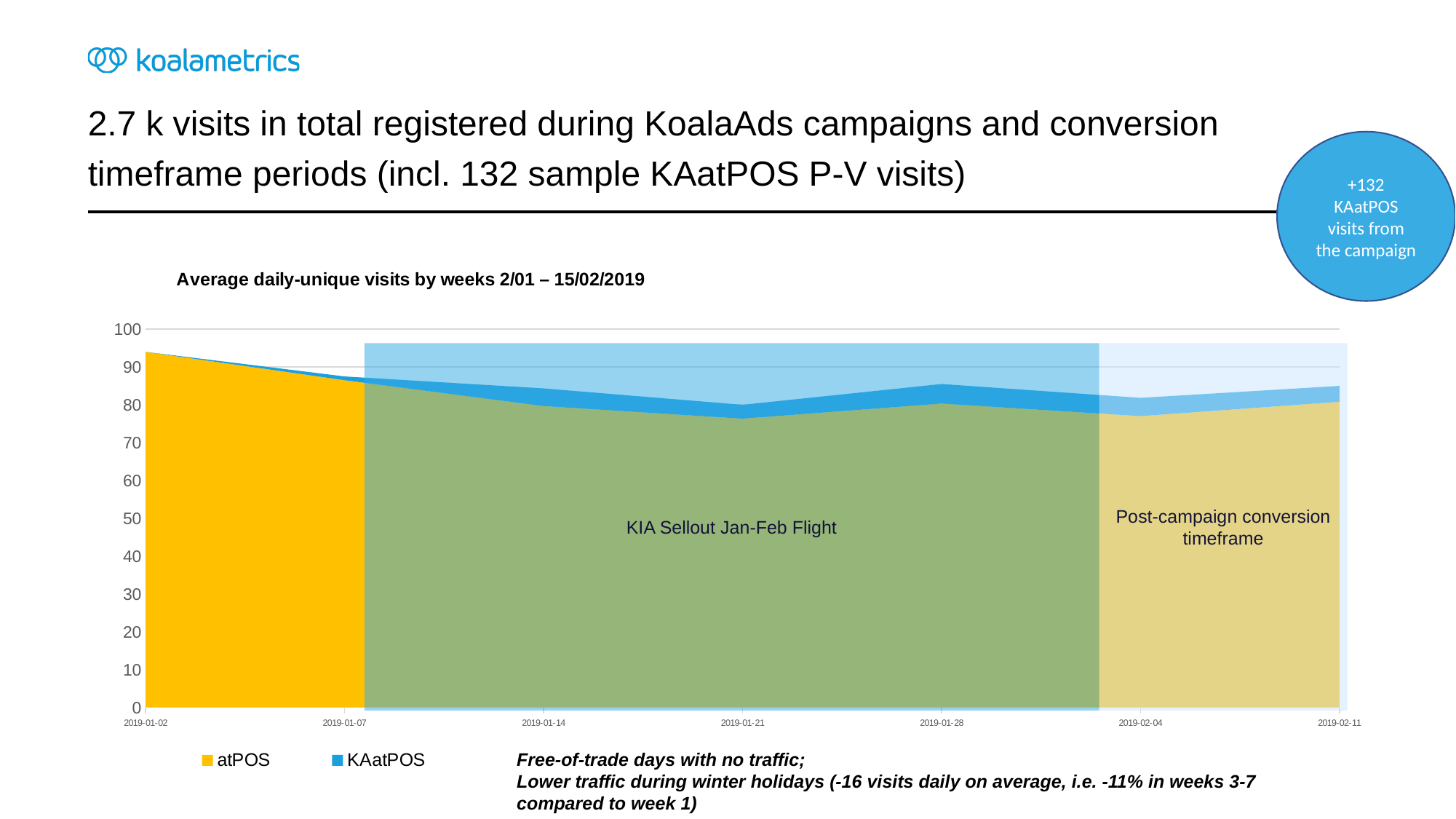
How many series does the legend list? 2 Does the atPOS series rise or fall from 2019-01-02 to 2019-01-21? Fall Is the atPOS value at 2019-02-04 greater or less than 80? less What kind of chart is shown on the slide? Area chart Is the atPOS value at 2019-01-21 greater or less than 80? less At which date is the atPOS value highest? 2019-01-02 What is the title of the chart? Average daily-unique visits by weeks 2/01 – 15/02/2019 How many dates are labelled on the x axis? 7 Is the atPOS value at 2019-01-07 greater or less than 80? greater Which series is shown in yellow in the legend? atPOS Which is larger, the atPOS value at 2019-01-02 or at 2019-02-11? 2019-01-02